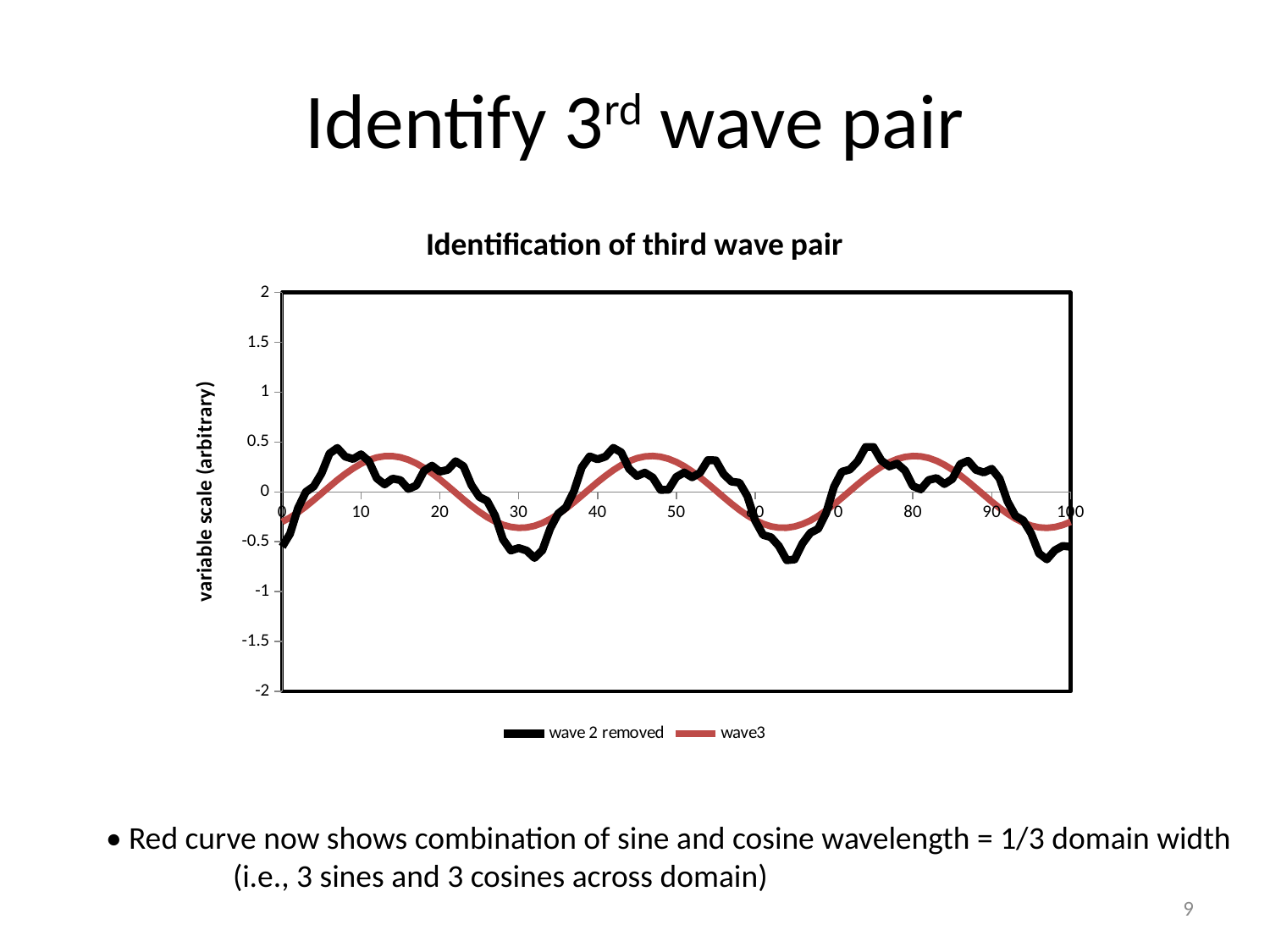
Is the value of the wave 2 removed series at x = 40 greater or less than 0? greater Is the lowest value reached by the wave3 series greater or less than -0.5? greater Is the value of the wave3 series at x = 30 greater or less than 0? less What is the title of the chart? Identification of third wave pair At x = 30, which series has the larger value, wave 2 removed or wave3? wave3 What kind of chart is shown on the slide? line chart How many series does the legend list? 2 What is the label on the vertical axis of the chart? variable scale (arbitrary)